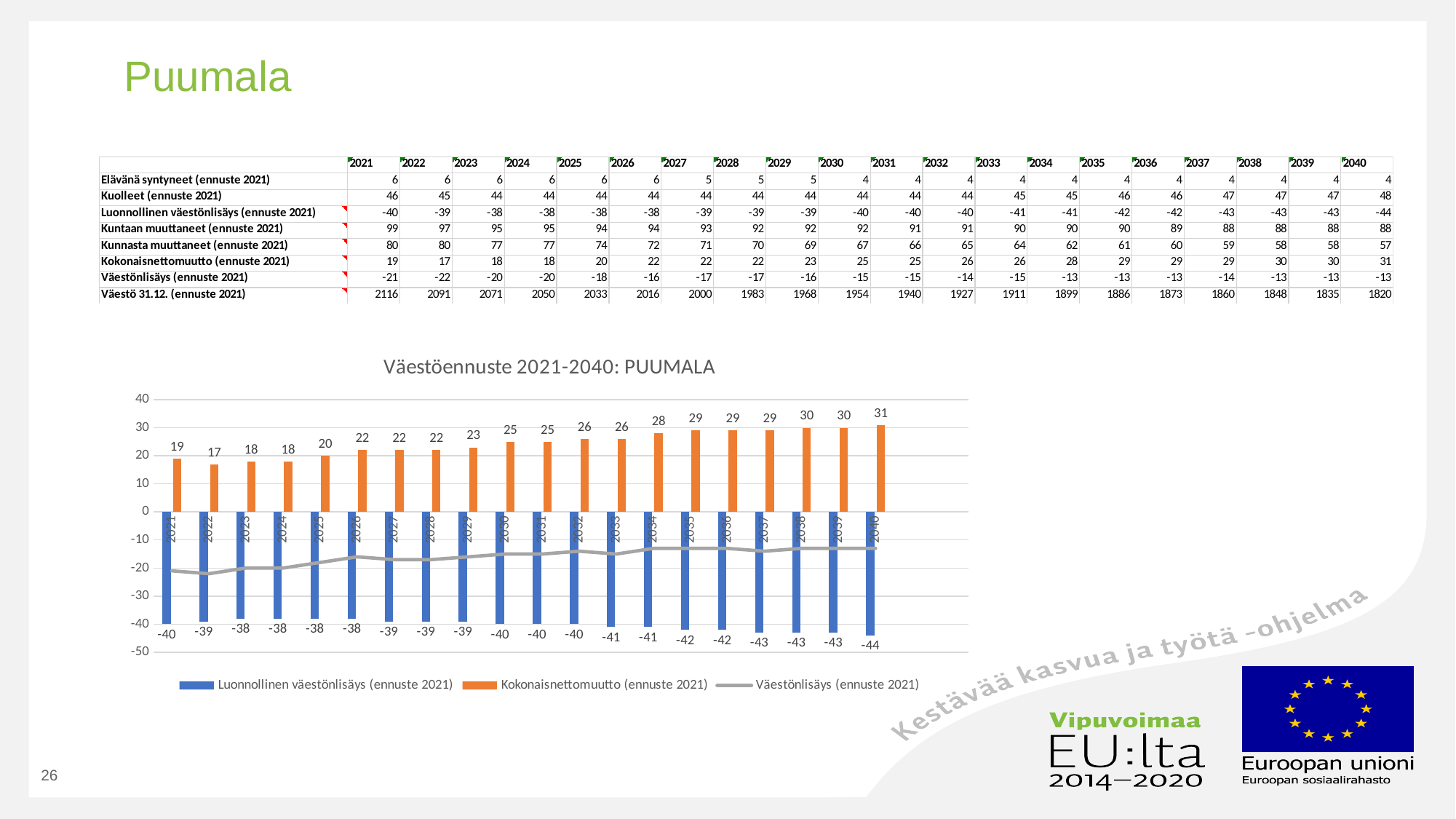
In which year is Kokonaisnettomuutto (ennuste 2021) highest? 2040 What is the value of Luonnollinen väestönlisäys (ennuste 2021) for 2040? -44 What kind of chart is shown on the slide? combination bar and line chart What is the value of Kokonaisnettomuutto (ennuste 2021) for 2021? 19 Does Kokonaisnettomuutto (ennuste 2021) generally rise or fall from 2021 to 2040? rise How many series does the chart legend list? 3 In which year is Kokonaisnettomuutto (ennuste 2021) lowest? 2022 How many years are shown on the x axis of the chart? 20 Is the value of the Väestönlisäys (ennuste 2021) line for 2021 greater or less than -10? less Which year has the larger Kokonaisnettomuutto (ennuste 2021) value, 2025 or 2030? 2030 What colour are the Kokonaisnettomuutto (ennuste 2021) bars? orange By how much does Kokonaisnettomuutto (ennuste 2021) in 2040 exceed its value in 2021? 12